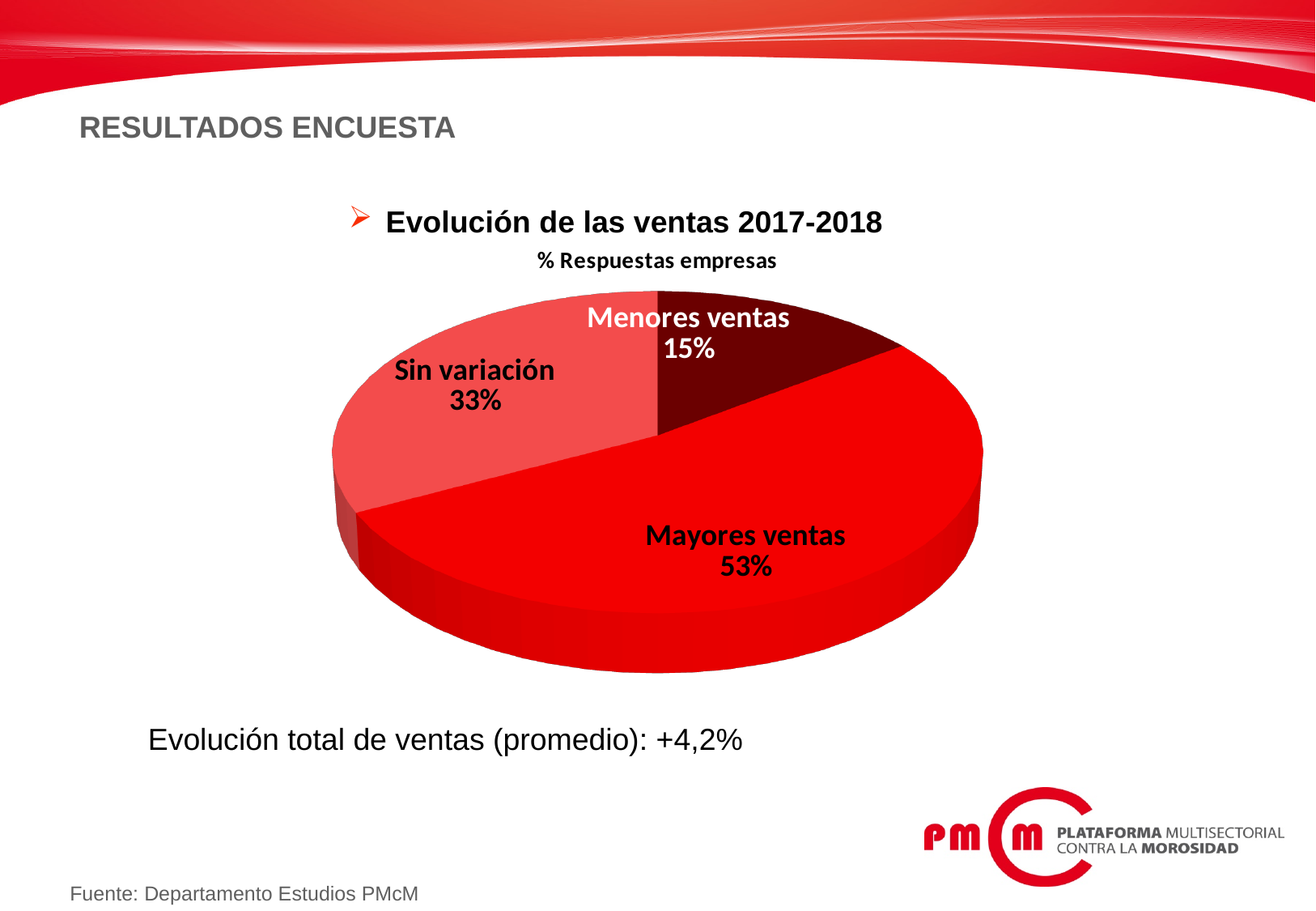
What is the difference in percentage points between 'Mayores ventas' and 'Sin variación'? 20 What is the difference in percentage points between 'Sin variación' and 'Menores ventas'? 18 Which category has the largest share of the pie? Mayores ventas Which category has the smallest share of the pie? Menores ventas Which is larger, the share for 'Sin variación' or the share for 'Menores ventas'? Sin variación What is the subtitle shown above the pie chart? % Respuestas empresas What is the title of the chart section on the slide? Evolución de las ventas 2017-2018 What percentage of companies reported 'Sin variación'? 33% What kind of chart is shown on the slide? Pie chart How many categories are shown in the pie chart? 3 What percentage of companies reported 'Menores ventas'? 15% What percentage of companies reported 'Mayores ventas'? 53%